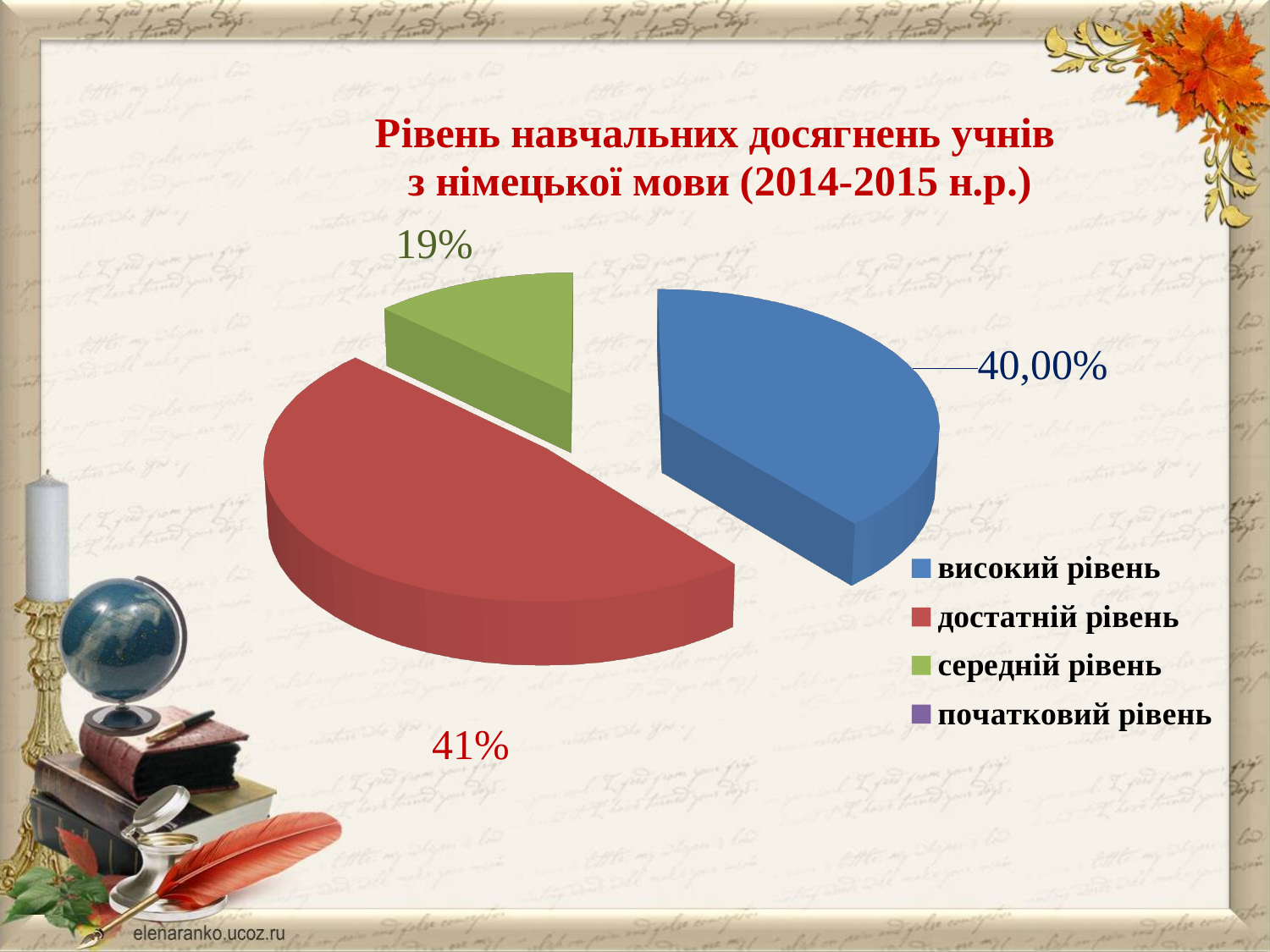
What is the difference between the достатній рівень and середній рівень values? 22% Which is larger, the високий рівень slice or the середній рівень slice? високий рівень What kind of chart is shown on the slide? pie chart What is the value shown for the достатній рівень slice? 41% What is the title of the chart? Рівень навчальних досягнень учнів з німецької мови (2014-2015 н.р.) How many slices are visible in the pie? 3 Which of the visible slices is the smallest? середній рівень What is the value shown for the середній рівень slice? 19% Which category has the largest slice of the pie? достатній рівень What is the value shown for the високий рівень slice? 40,00% What colour is the достатній рівень slice? red How many categories does the legend list? 4